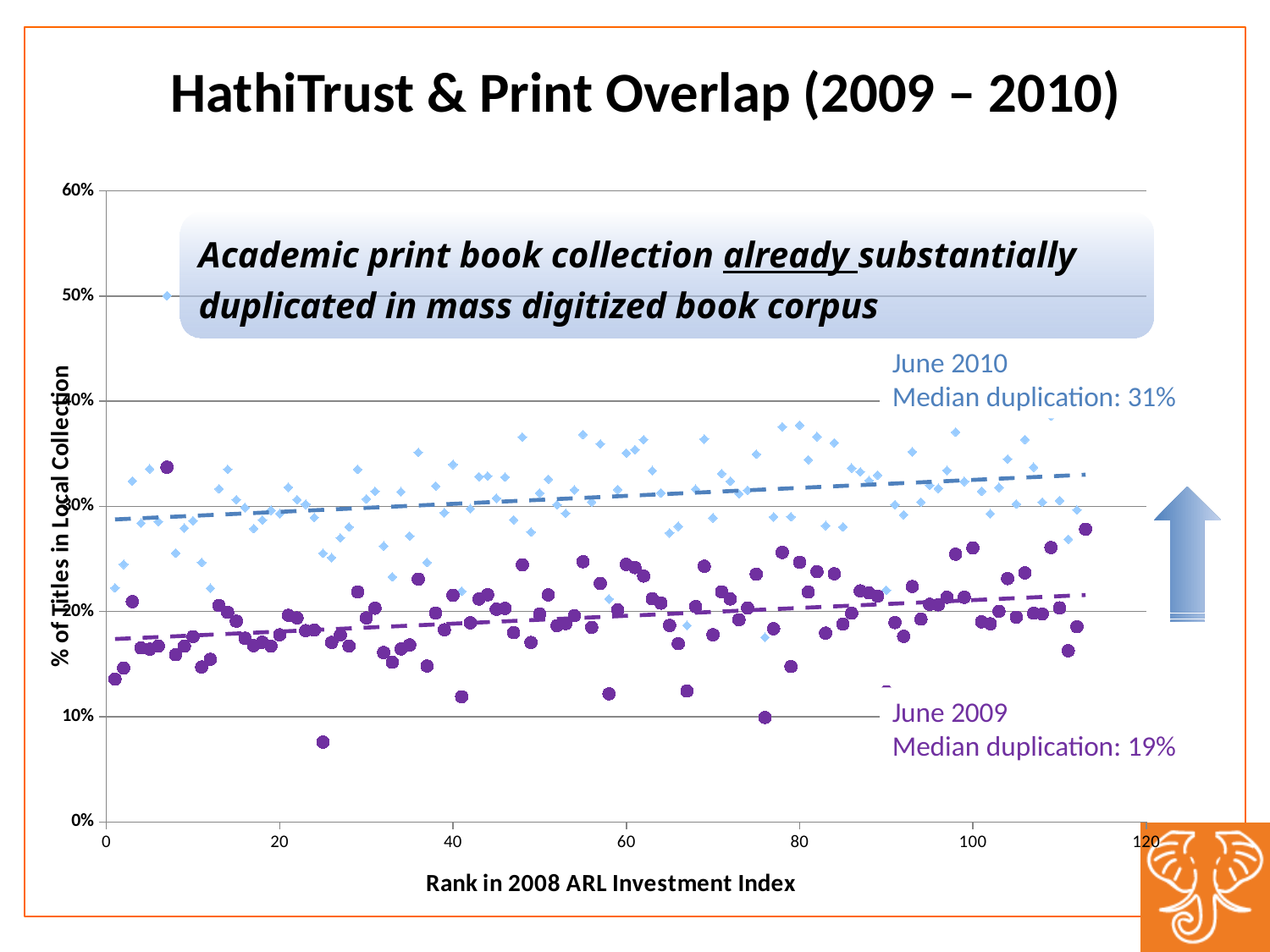
What is the median duplication for June 2010? 31% Is the June 2010 median duplication greater or less than 30%? greater What is the difference between the June 2010 and June 2009 median duplication values? 12 percentage points What is the highest value shown on the y axis? 60% Is the June 2009 median duplication greater or less than 20%? less What is the label of the x axis? Rank in 2008 ARL Investment Index Which year has the higher median duplication, June 2009 or June 2010? June 2010 Do the dashed trend lines rise or fall as the rank in the 2008 ARL Investment Index increases? Rise What is the label of the y axis? % of Titles in Local Collection What is the median duplication for June 2009? 19% What kind of chart is shown on the slide? Scatter chart How many data series are plotted on the chart? 2